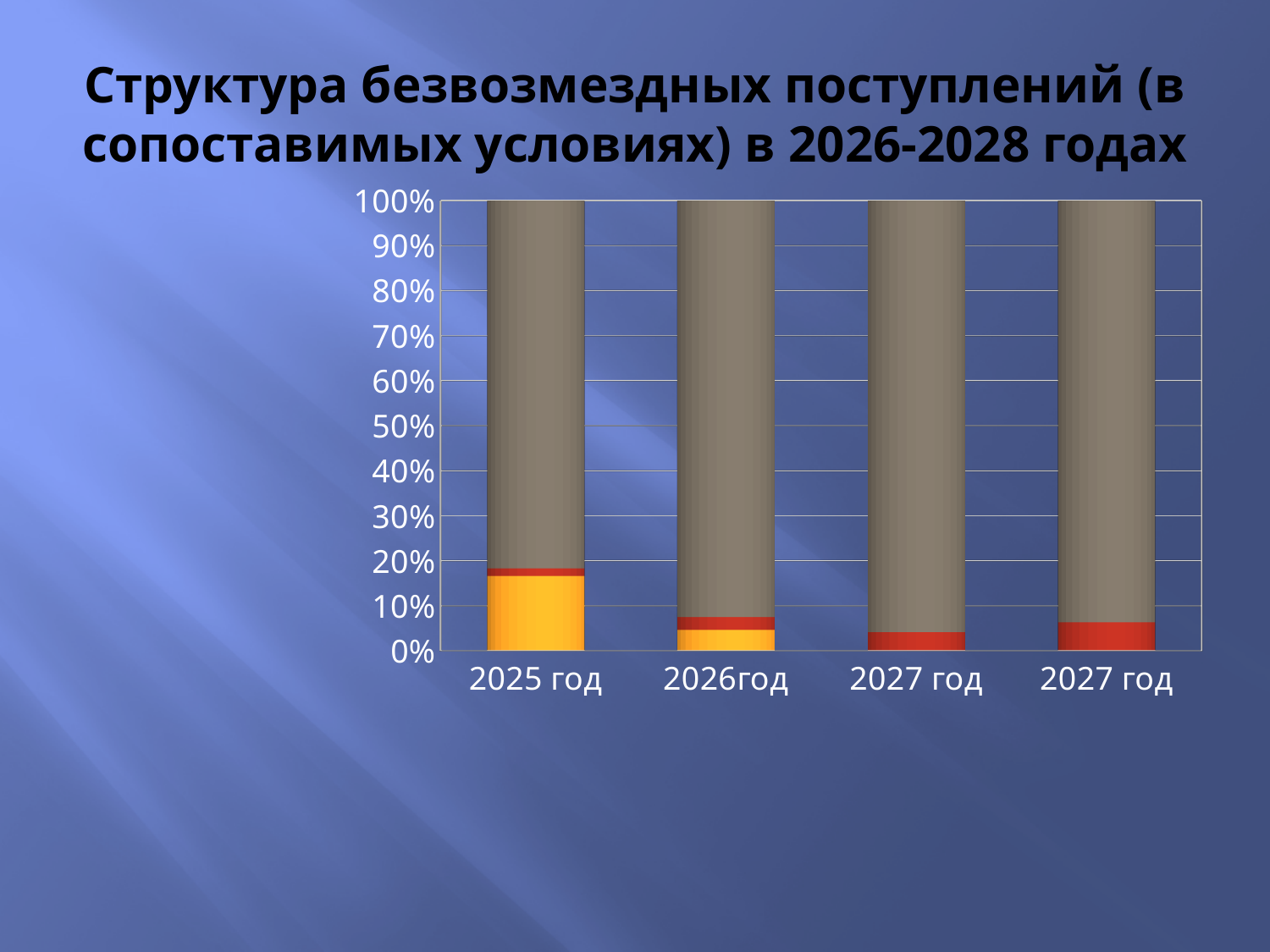
Is the grey segment for 2026год greater or less than 90%? greater Is the red segment in the third bar (2027 год) greater or less than 10%? less Is the yellow segment for 2026год greater or less than 10%? less What is the total height of each stacked bar on the chart? 100% How many differently coloured segments are used in the stacked bars? 3 Which bar has the smallest grey segment? 2025 год What is the title of the chart on the slide? Структура безвозмездных поступлений (в сопоставимых условиях) в 2026-2028 годах How many bars (categories) are shown on the x axis of the chart? 4 Which bar has the larger yellow segment, 2025 год or 2026год? 2025 год What kind of chart is shown on the slide? stacked bar chart